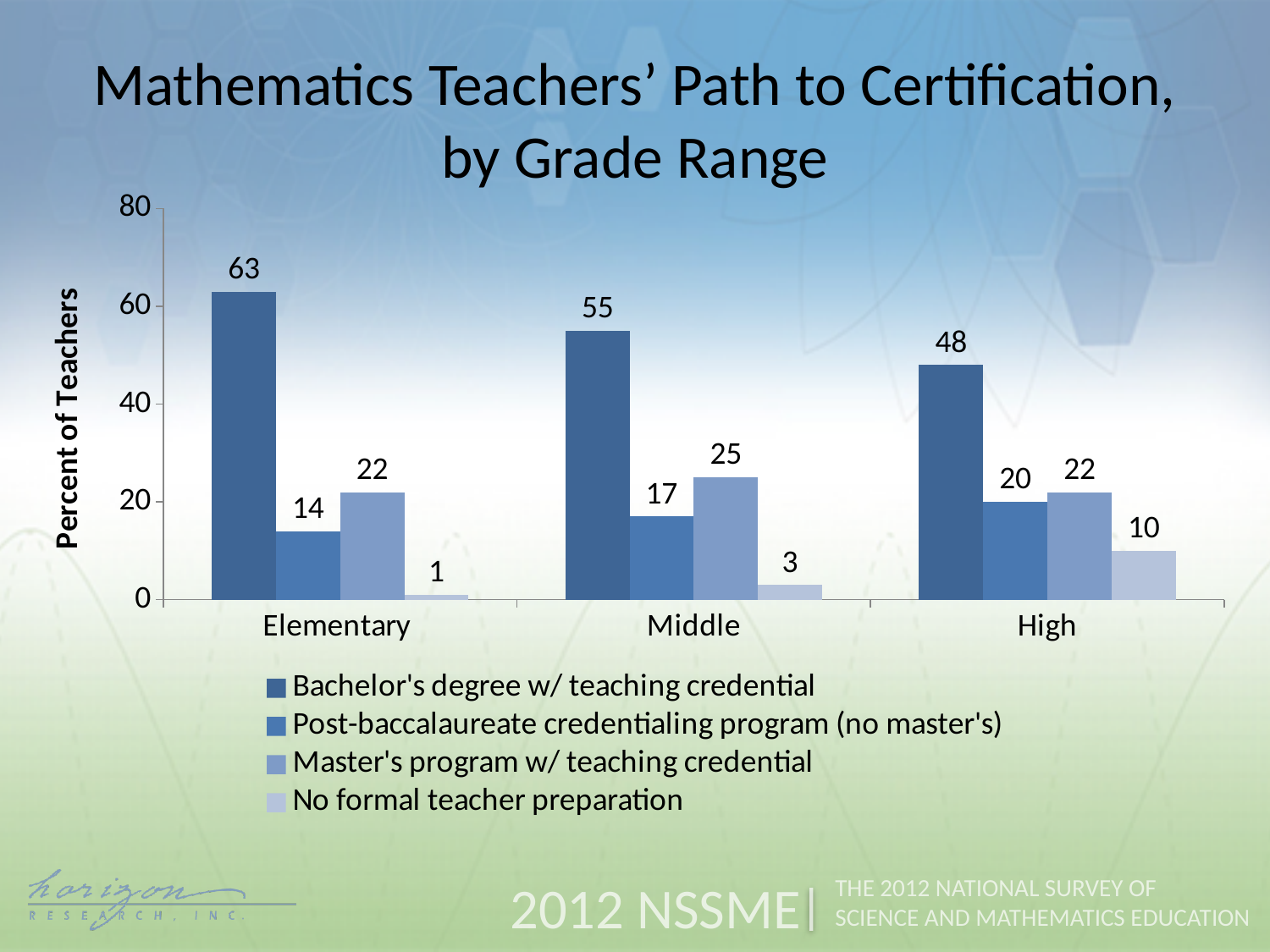
Which grade range has the highest value for Bachelor's degree w/ teaching credential? Elementary How many series does the legend list? 4 How many grade ranges are shown on the x axis? 3 What kind of chart is shown on the slide? Bar chart Do the values for Bachelor's degree w/ teaching credential rise or fall from Elementary to High? Fall What is the value for Master's program w/ teaching credential for Middle grade teachers? 25 What is the difference between the Bachelor's degree w/ teaching credential values for Elementary and High? 15 What percent of elementary mathematics teachers have a Bachelor's degree w/ teaching credential? 63 Is the value for Bachelor's degree w/ teaching credential for Middle greater or less than 40? greater Which grade range has the lowest value for No formal teacher preparation? Elementary What percent of High grade teachers have No formal teacher preparation? 10 Which is larger: the Post-baccalaureate credentialing program value for Middle or for High? High